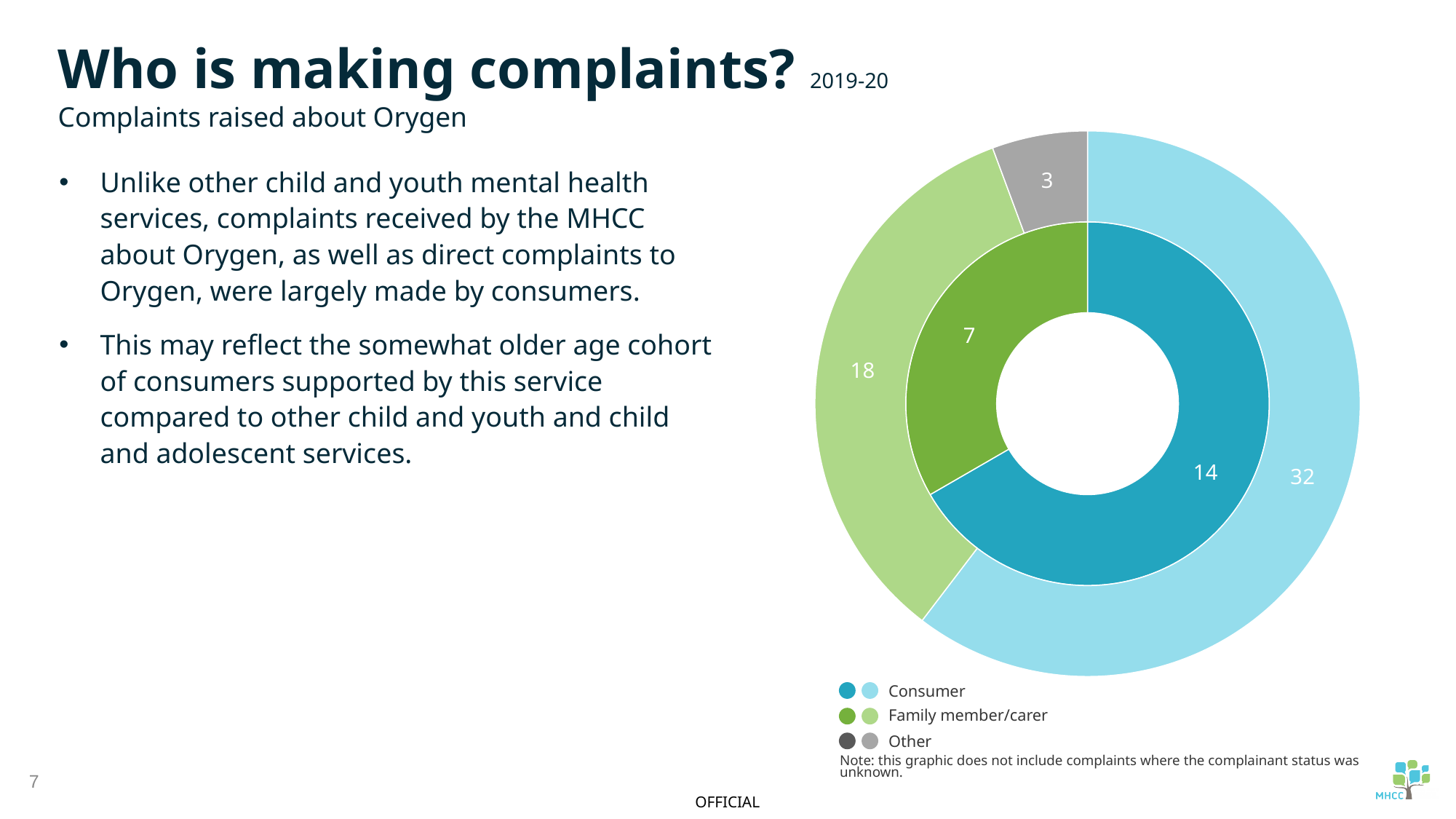
Which category has the smallest segment in the outer ring of the chart? Other In the inner ring of the chart, what is the value for Family member/carer? 7 In the inner ring of the chart, what is the value for Consumer? 14 In the outer ring, what is the difference between the Consumer value and the Family member/carer value? 14 What kind of chart is shown on the slide? Doughnut chart In the outer ring of the chart, what is the value for Consumer? 32 In the outer ring of the chart, what is the value for Other? 3 In the inner ring, which is larger: Consumer or Family member/carer? Consumer In the outer ring of the chart, what is the value for Family member/carer? 18 What are the three categories listed in the chart legend? Consumer, Family member/carer, Other How many categories does the chart legend list? 3 Which category has the largest segment in the outer ring of the chart? Consumer